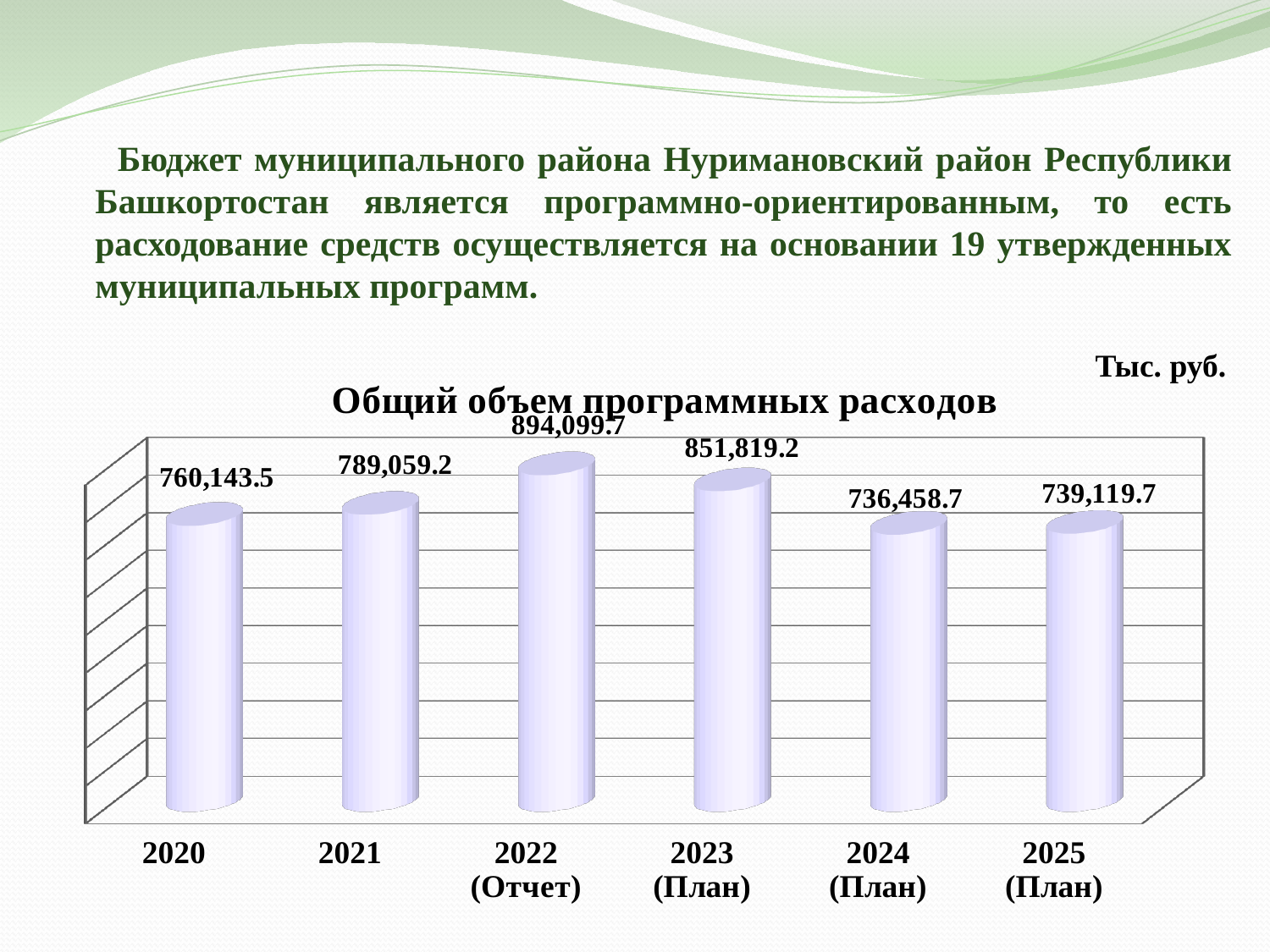
What is the value for 2024 (План) in the chart? 736,458.7 Which is larger, the value for 2022 (Отчет) or the value for 2023 (План)? 2022 (Отчет) What is the value for 2022 (Отчет) in the chart 'Общий объем программных расходов'? 894,099.7 What is the difference between the values for 2022 (Отчет) and 2020? 133,956.2 What is the value for 2020 in the chart? 760,143.5 Do the values rise or fall from 2020 to 2022 (Отчет)? rise What is the value for 2025 (План) in the chart? 739,119.7 What kind of chart is shown on the slide? bar chart What is the difference between the values for 2023 (План) and 2024 (План)? 115,360.5 Which year has the lowest value in the chart? 2024 (План) Which year has the highest value in the chart? 2022 (Отчет) How many years are shown on the x axis of the chart? 6